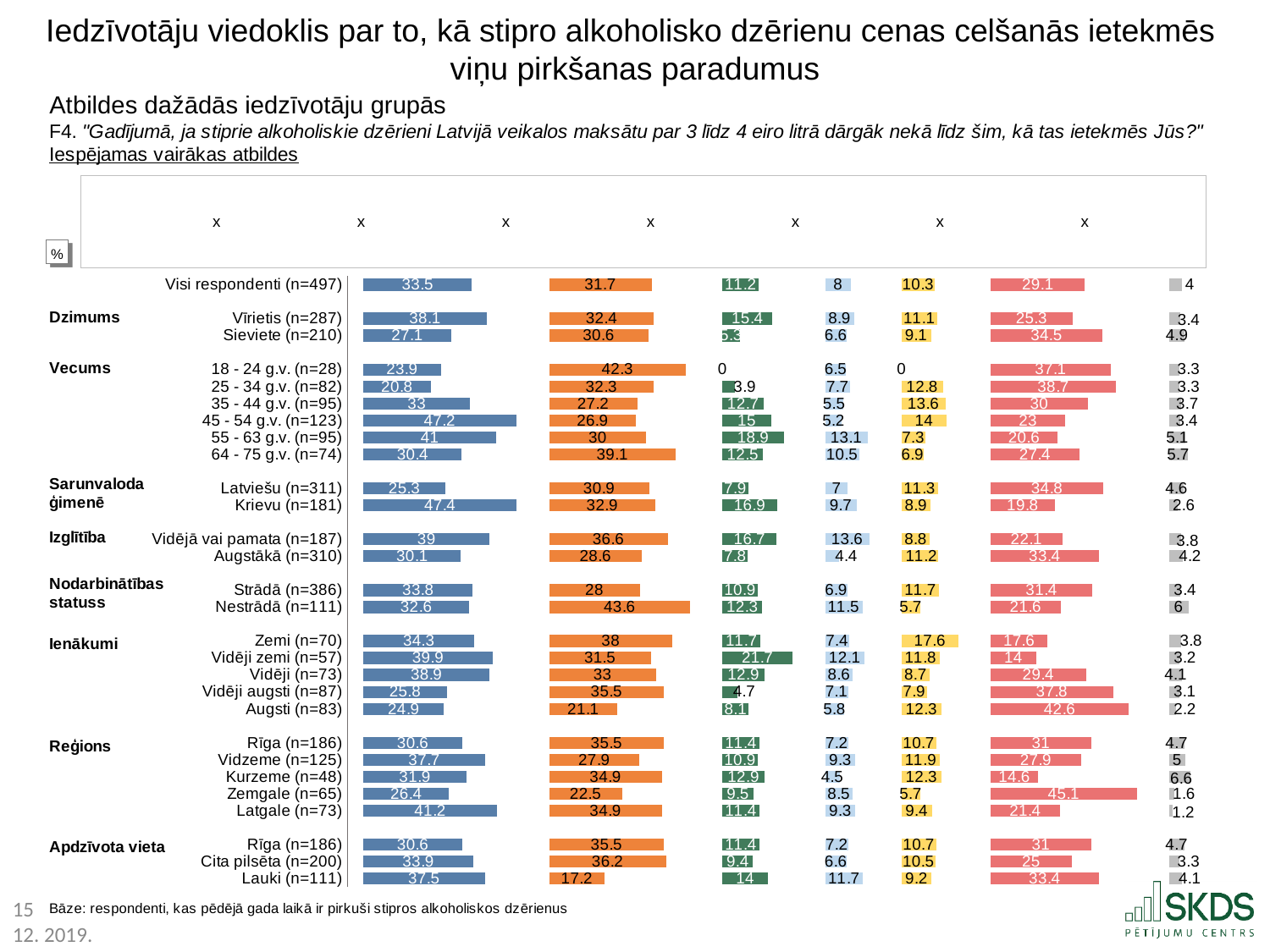
Which has the larger blue series value: "Latviešu (n=311)" or "Krievu (n=181)"? Krievu (n=181) What is the value of the last (grey) series for "Latgale (n=73)"? 1.2 Among the regions (Reģions), which has the lowest value in the red series? Kurzeme (n=48) Among the age groups (Vecums), which has the highest value in the blue series? 45 - 54 g.v. (n=123) How many data series (columns of bars) does the chart show? 7 What is the difference between the blue series values for "Vīrietis (n=287)" and "Sieviete (n=210)"? 11 How many age groups are listed under "Vecums"? 6 What is the value of the red series for "Zemgale (n=65)"? 45.1 What is the value of the first (blue) series for "Visi respondenti (n=497)"? 33.5 What is the value of the orange series for "Nestrādā (n=111)"? 43.6 Among the income groups (Ienākumi), which has the highest value in the red series? Augsti (n=83) What kind of chart is shown on the slide? Bar chart